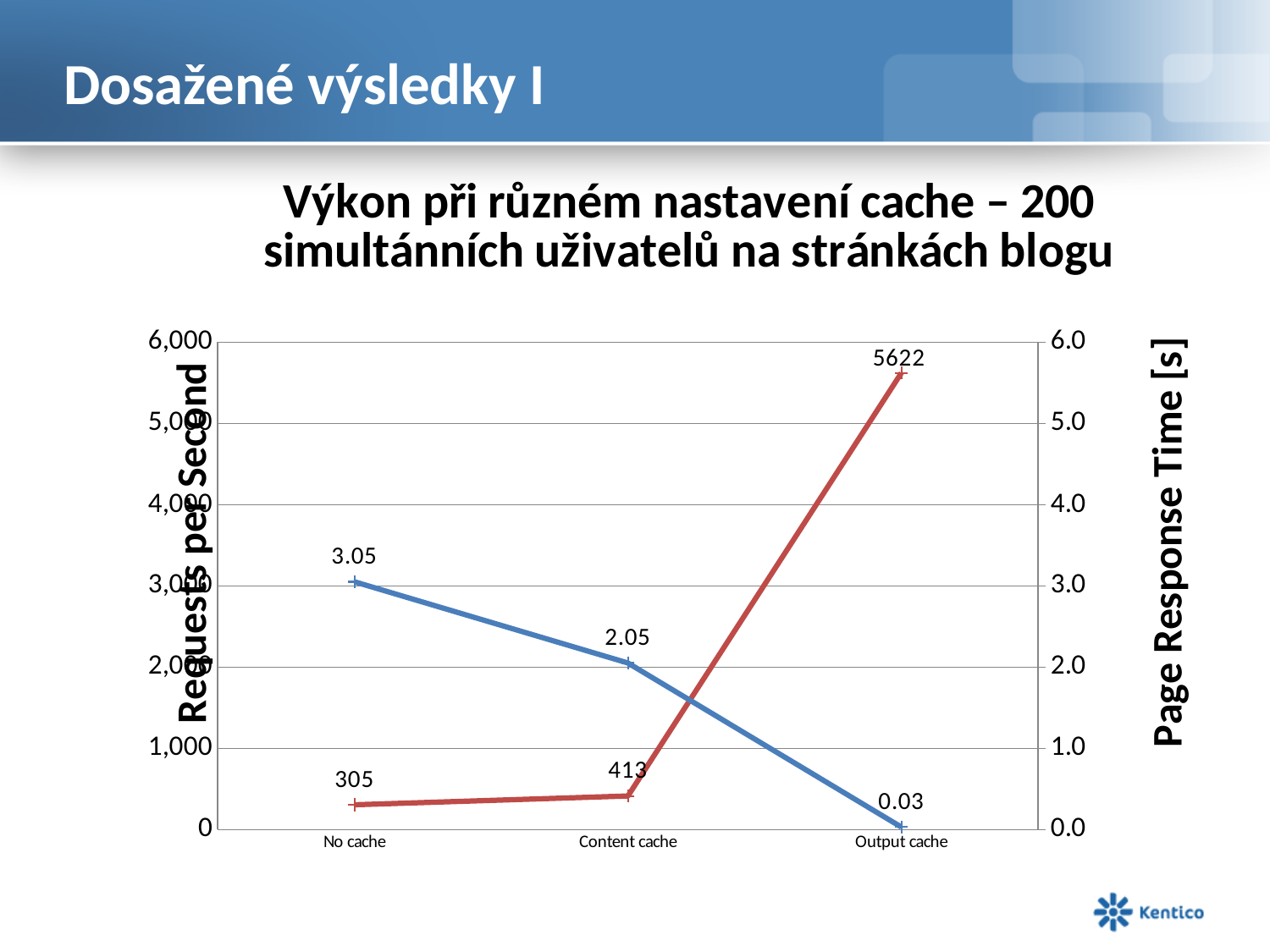
Which has a higher Requests per Second value, No cache or Content cache? Content cache What is the Page Response Time for Content cache? 2.05 Does the Page Response Time rise or fall from No cache to Output cache? Fall Which cache setting has the lowest Page Response Time? Output cache How many cache settings are shown on the x axis? 3 What is the Requests per Second value for No cache? 305 What is the difference in Page Response Time between No cache and Content cache? 1.00 What is the Page Response Time for Output cache? 0.03 What is the difference in Requests per Second between Output cache and Content cache? 5209 Which cache setting has the highest Requests per Second? Output cache What is the Requests per Second value for Output cache? 5622 What type of chart is shown on the slide? Line chart